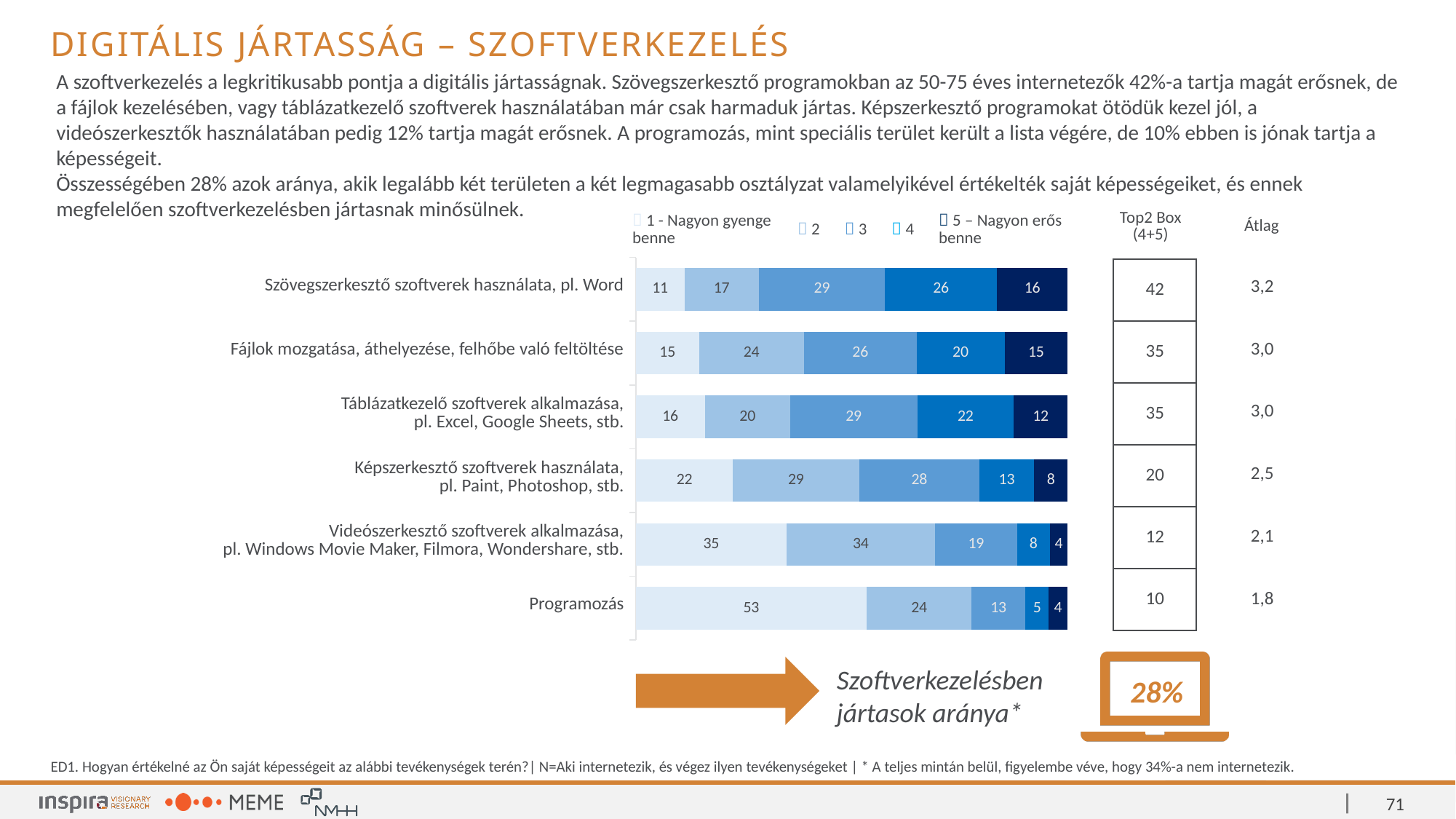
What is the value of the '5 – Nagyon erős benne' segment for 'Szövegszerkesztő szoftverek használata, pl. Word'? 16 Which category has the lowest Átlag value? Programozás What is the Átlag value for 'Videószerkesztő szoftverek alkalmazása, pl. Windows Movie Maker, Filmora, Wondershare, stb.'? 2,1 How many series does the chart legend list? 5 What is the difference between the '1 - Nagyon gyenge benne' values for 'Programozás' and 'Videószerkesztő szoftverek alkalmazása'? 18 How many categories (activities) are plotted in the chart? 6 What is the total of the stacked bar for 'Fájlok mozgatása, áthelyezése, felhőbe való feltöltése'? 100 Which category has the highest Top2 Box (4+5) value? Szövegszerkesztő szoftverek használata, pl. Word Which is larger: the '3' segment for 'Fájlok mozgatása, áthelyezése, felhőbe való feltöltése' or the '3' segment for 'Táblázatkezelő szoftverek alkalmazása'? Táblázatkezelő szoftverek alkalmazása What is the value of the '1 - Nagyon gyenge benne' segment for 'Programozás'? 53 What is the Top2 Box (4+5) value for 'Képszerkesztő szoftverek használata, pl. Paint, Photoshop, stb.'? 20 What kind of chart is shown on the slide? stacked bar chart